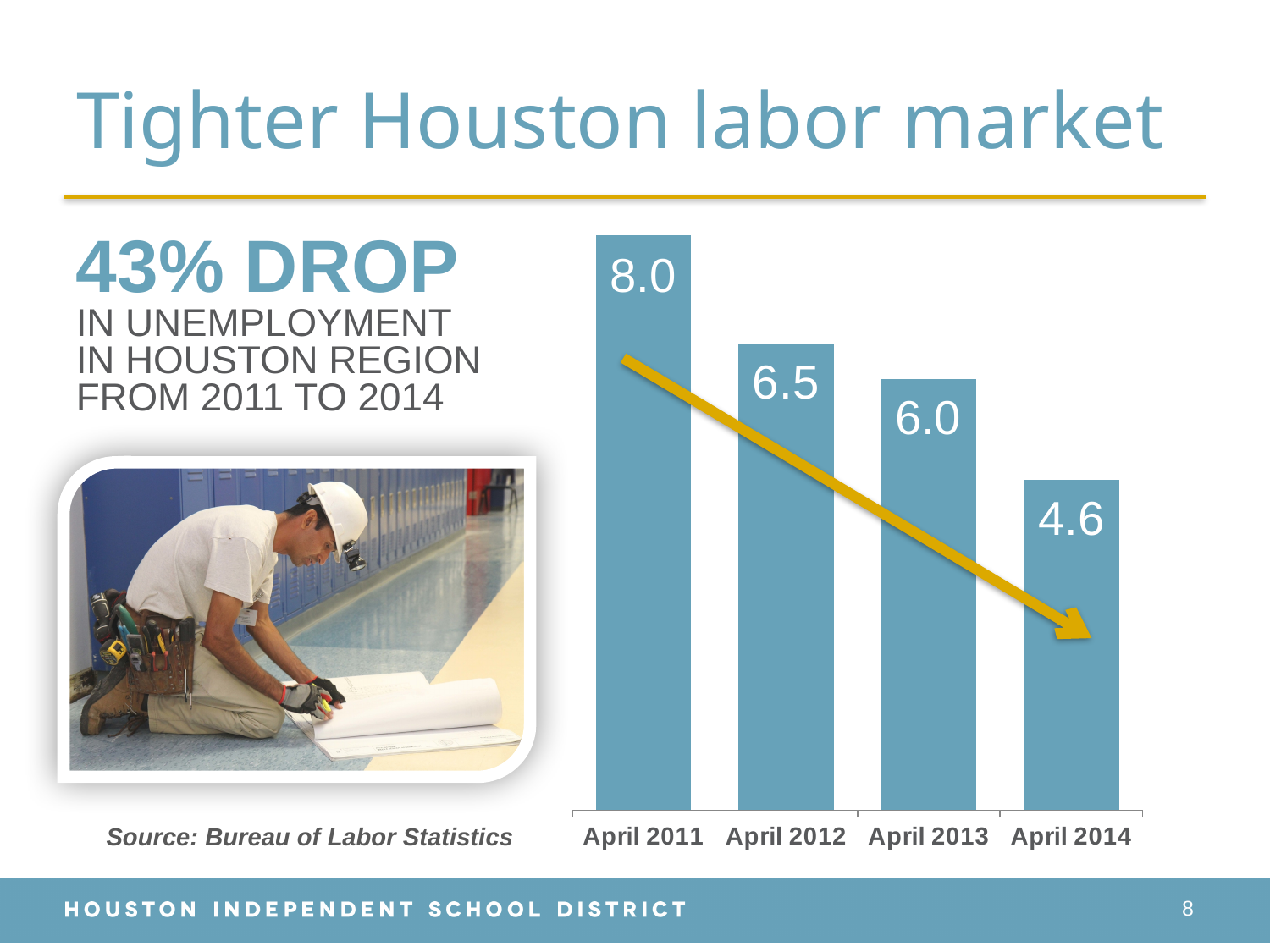
What is the value for April 2012? 6.5 What is the value for April 2014? 4.6 Which is larger, the value for April 2012 or the value for April 2014? April 2012 What kind of chart is shown on the slide? Bar chart Which category has the lowest value? April 2014 Do the values rise or fall from April 2011 to April 2014? Fall How many categories are shown on the x axis? 4 What is the difference between the values for April 2012 and April 2013? 0.5 What is the value for April 2013? 6.0 What is the difference between the values for April 2011 and April 2014? 3.4 Which category has the highest value? April 2011 What is the value for April 2011? 8.0